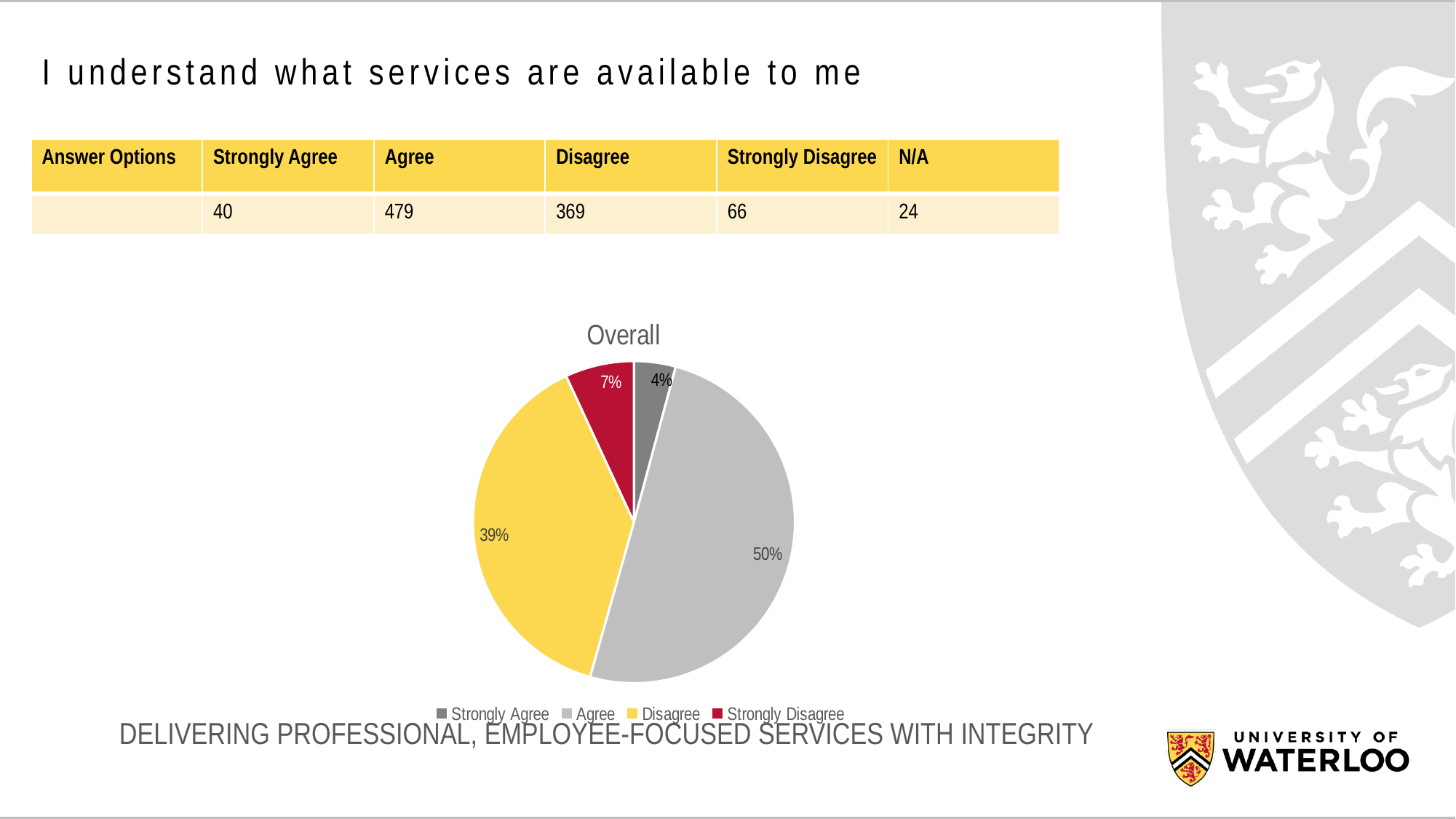
How many categories does the legend list? 4 What is the difference in percentage points between the Agree and Disagree slices? 11 What type of chart is shown on the slide? pie chart What percentage of the pie does the Agree slice represent? 50% Which category has the smallest slice of the pie? Strongly Agree What is the title of the chart? Overall What percentage of the pie does the Strongly Disagree slice represent? 7% What percentage of the pie does the Strongly Agree slice represent? 4% Which slice is larger, Strongly Disagree or Strongly Agree? Strongly Disagree What percentage of the pie does the Disagree slice represent? 39% Which category has the largest slice of the pie? Agree What colour is the Disagree slice? yellow